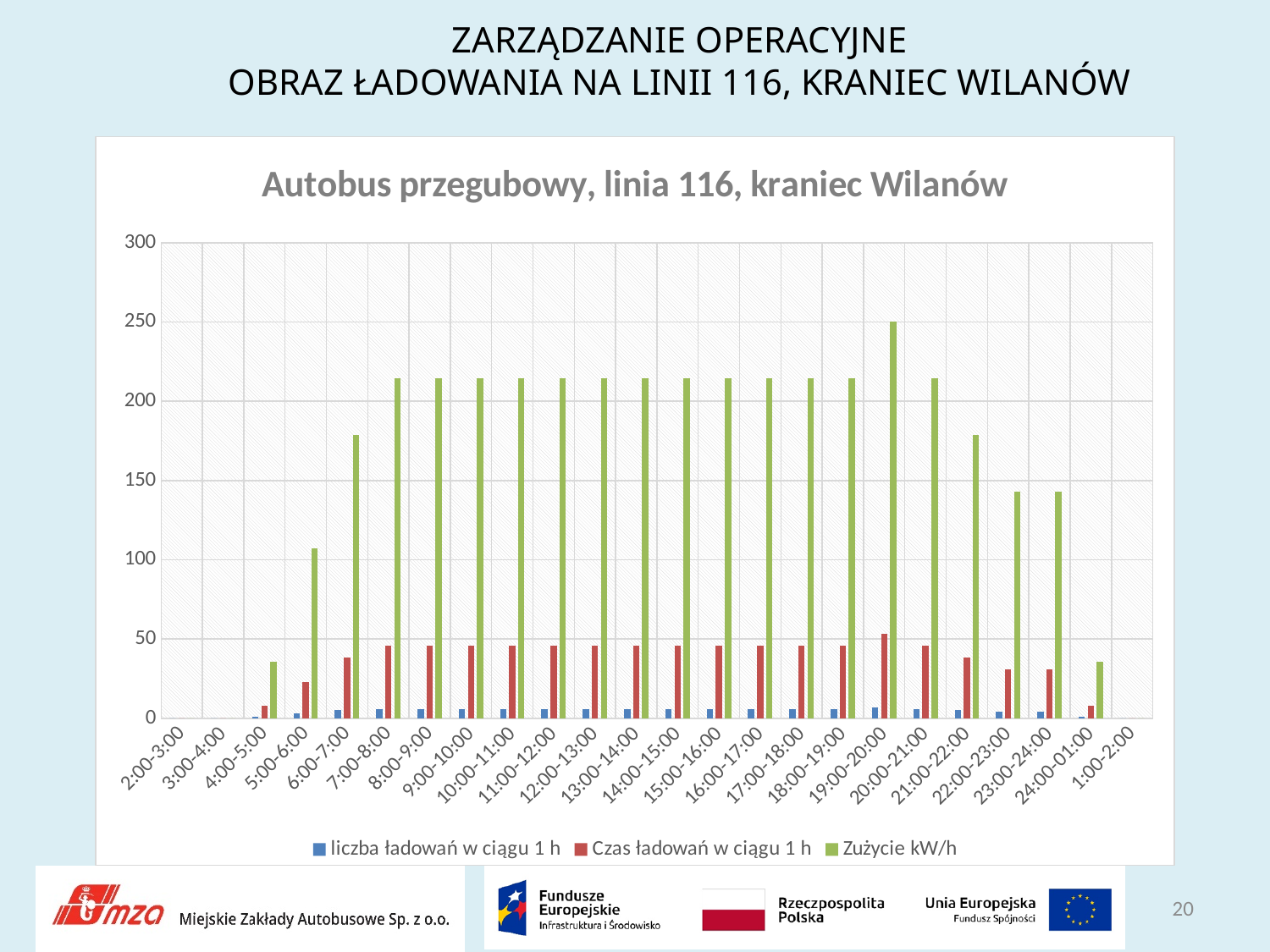
Does the Zużycie kW/h value rise or fall from 4:00-5:00 to 8:00-9:00? rise Which has the larger Zużycie kW/h value, 22:00-23:00 or 23:00-24:00? Neither; they are equal What is the title of the chart? Autobus przegubowy, linia 116, kraniec Wilanów In which time interval is the Zużycie kW/h value highest? 19:00-20:00 Which has the larger Zużycie kW/h value, 6:00-7:00 or 7:00-8:00? 7:00-8:00 Is the Zużycie kW/h value for 5:00-6:00 greater or less than 50? greater How many series does the legend list? 3 Is the Zużycie kW/h value for 23:00-24:00 greater or less than 150? less How many time-interval categories are shown on the x axis? 24 What type of chart is shown on the slide? bar chart Is the Zużycie kW/h value for 19:00-20:00 greater or less than 200? greater